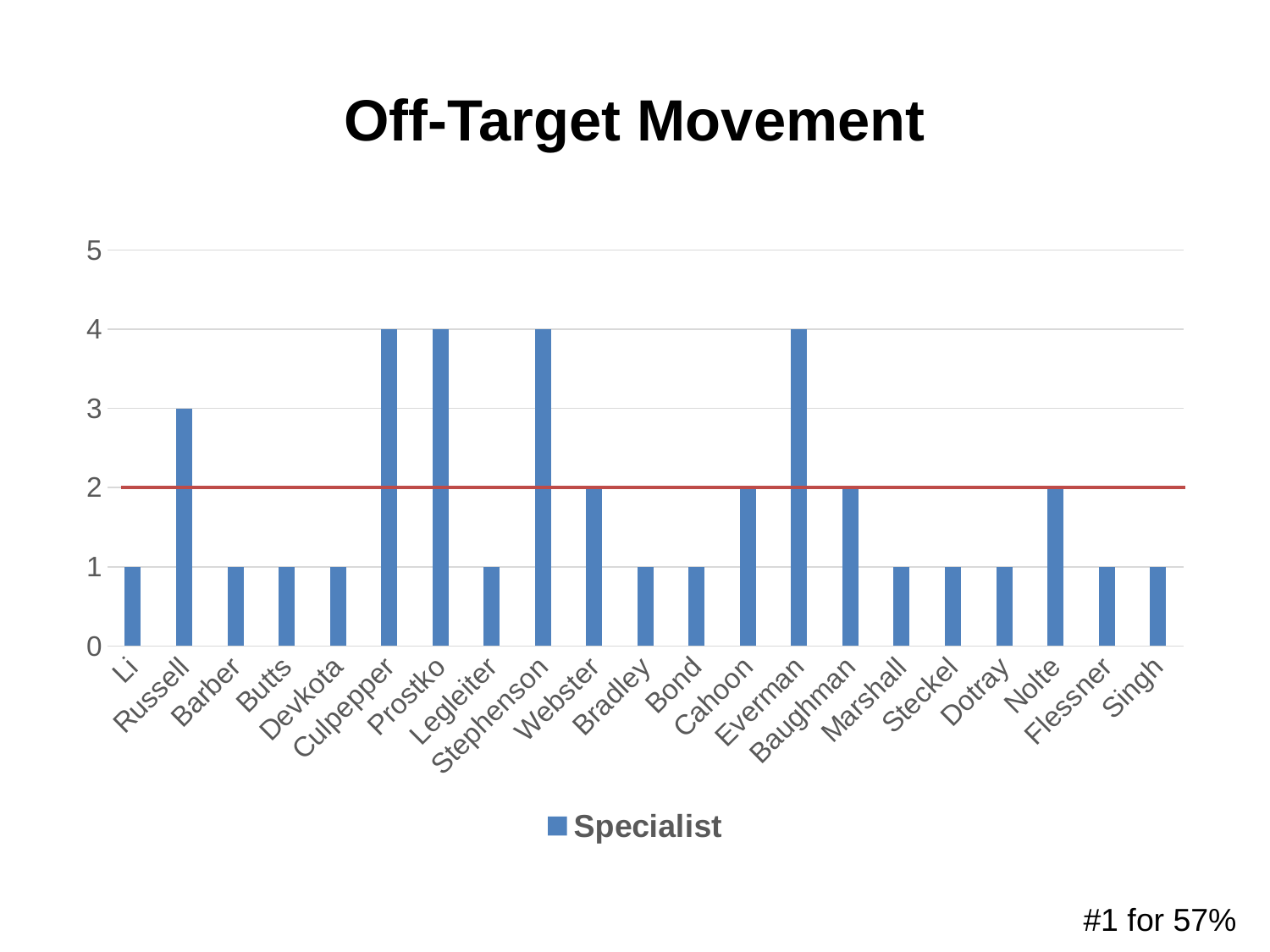
What is the title of the chart? Off-Target Movement At what value is the horizontal red line drawn? 2 Is the value for Everman greater or less than 2? greater What is the value for Culpepper? 4 What kind of chart is shown? bar chart What is the value for Li? 1 Which has the larger value, Russell or Webster? Russell How many specialists (categories) are shown on the x axis? 21 What is the value for Webster? 2 How many series does the legend list? 1 What is the difference between the values for Russell and Li? 2 What is the value for Russell? 3